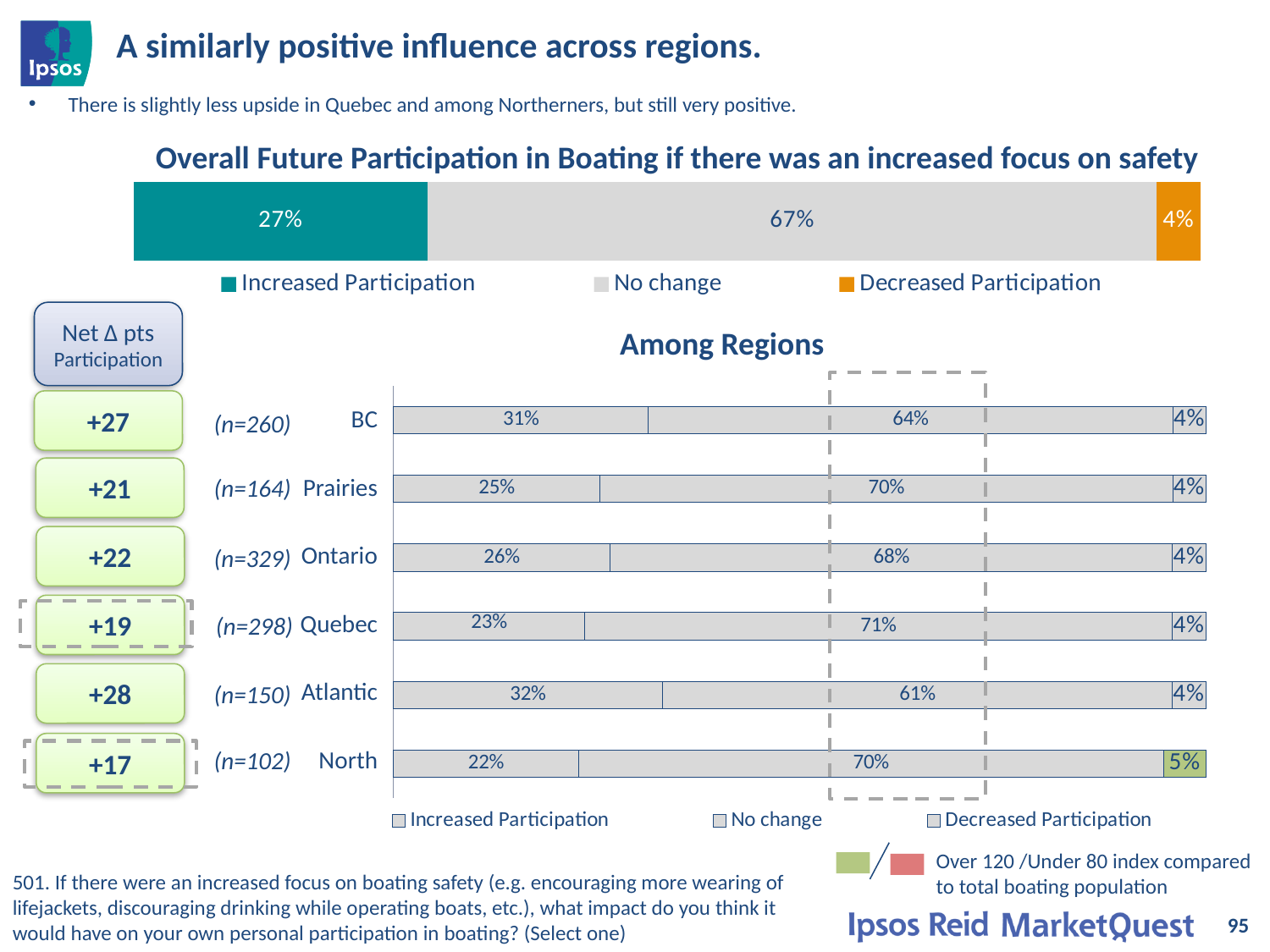
In the top overall chart, what is the total of the three segments (Increased Participation, No change, Decreased Participation)? 98% In the 'Among Regions' chart, which region has the lowest Increased Participation value? North In the 'Among Regions' chart, what is the difference between the Increased Participation values for Atlantic and Quebec? 9 percentage points How many series does the legend of the 'Among Regions' chart list? 3 In the 'Among Regions' chart, what is the Decreased Participation value for North? 5% In the 'Among Regions' chart, what percentage of BC respondents indicated Increased Participation? 31% In the 'Among Regions' chart, which has a larger No change value, Prairies or Ontario? Prairies In the 'Among Regions' chart, what is the No change value for Quebec? 71% What type of chart is the 'Among Regions' chart? Stacked bar chart In the 'Among Regions' chart, which region has the highest Increased Participation value? Atlantic How many regions are shown in the 'Among Regions' chart? 6 In the top overall chart, what percentage of respondents indicated No change? 67%